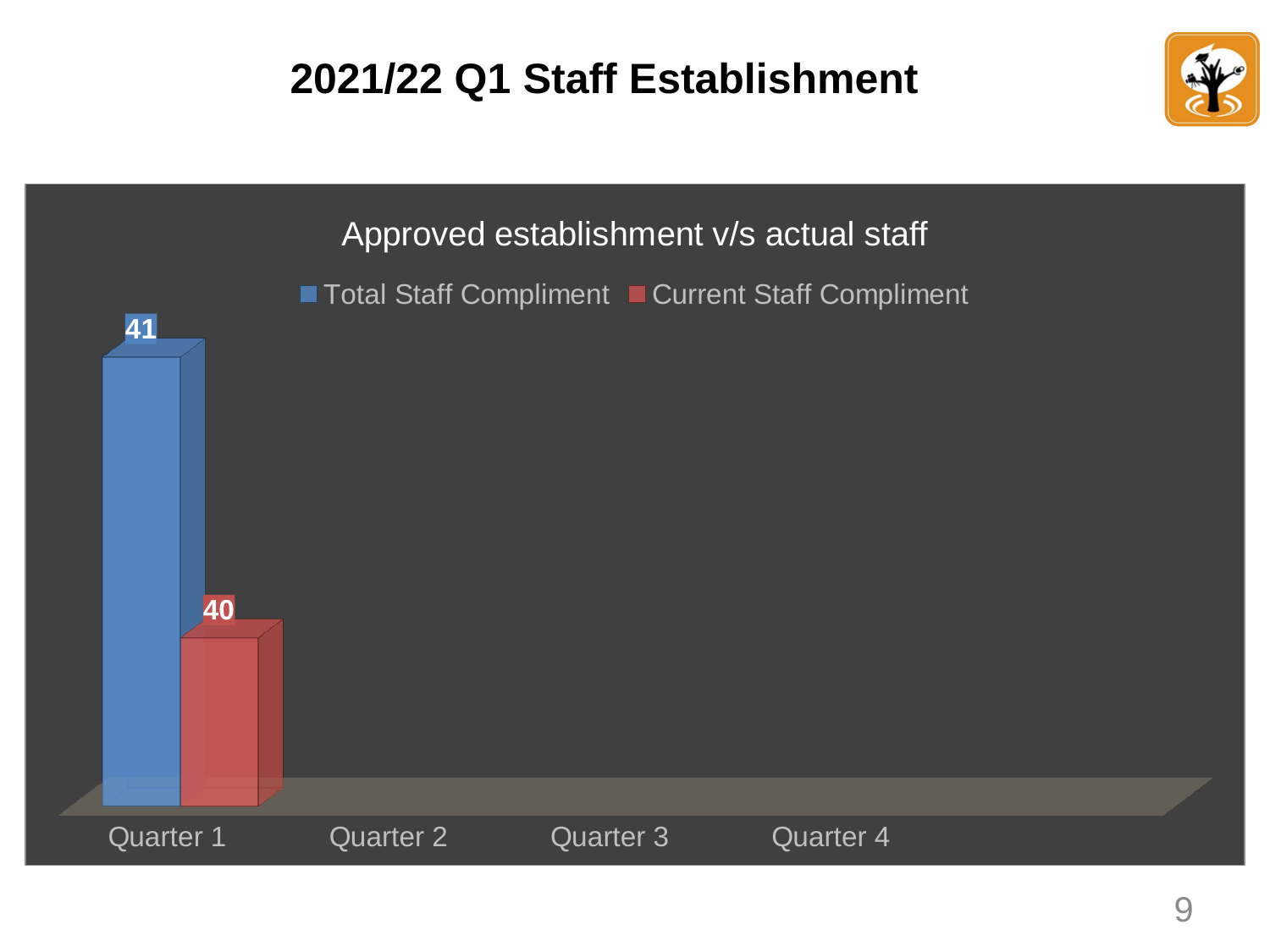
How many series does the legend list? 2 Which colour represents Current Staff Compliment in the chart? Red What is the difference between Total Staff Compliment and Current Staff Compliment in Quarter 1? 1 What is the value of Current Staff Compliment for Quarter 1? 40 What is the value of Total Staff Compliment for Quarter 1? 41 What kind of chart is shown on the slide? Bar chart How many categories are shown on the x axis? 4 Which series has the larger value in Quarter 1, Total Staff Compliment or Current Staff Compliment? Total Staff Compliment What is the title of the chart? Approved establishment v/s actual staff Which quarter is the only one with plotted bars? Quarter 1